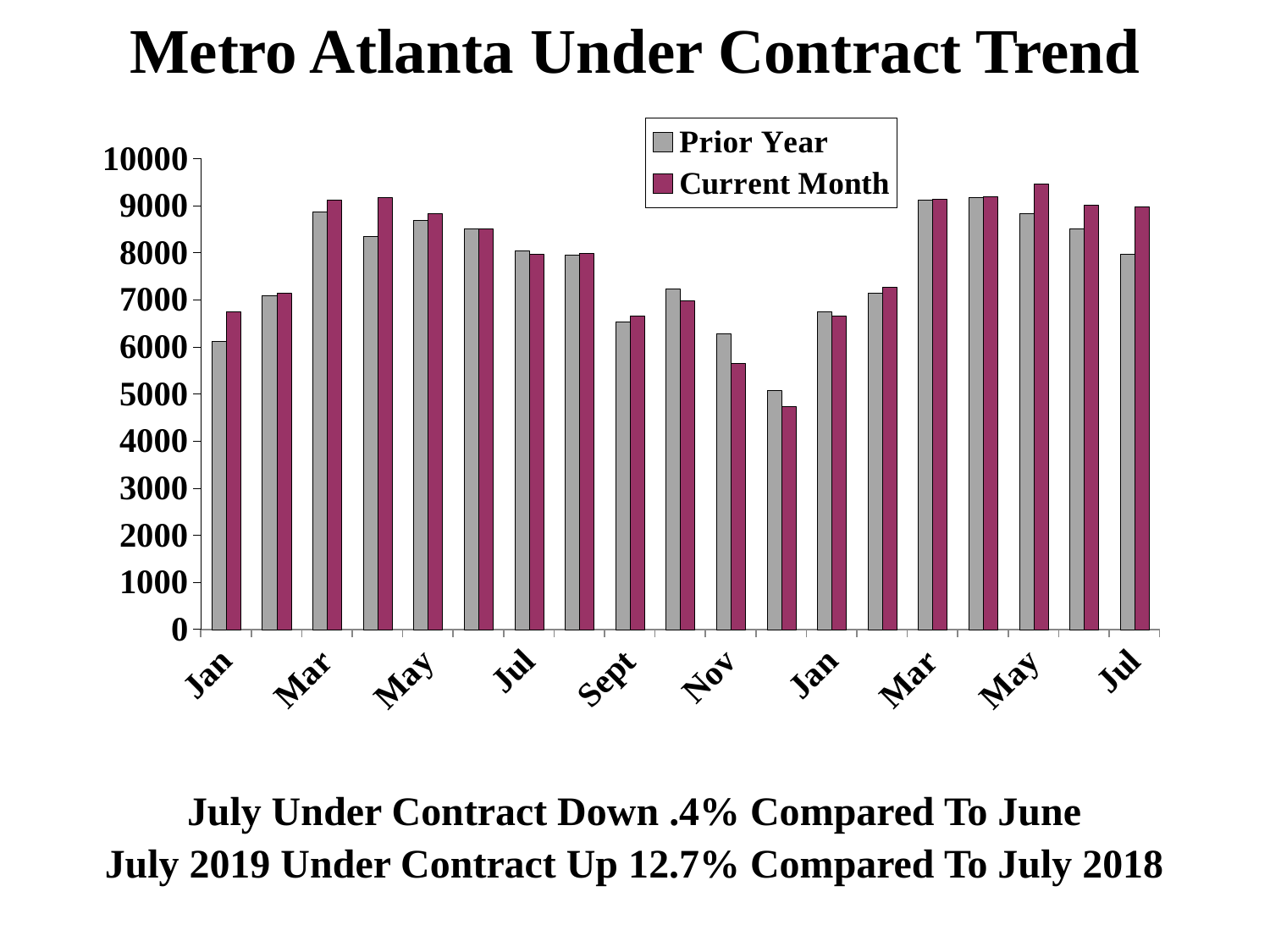
What is the title of the chart? Metro Atlanta Under Contract Trend Is the Prior Year value for the first Jan greater or less than 5000? greater For the first Nov, which is larger, the Prior Year value or the Current Month value? Prior Year How many series does the legend list? 2 Is the Current Month value for the first Sept greater or less than 7000? less Is the Prior Year value for the first May greater or less than 8000? greater What kind of chart is shown on the slide? bar chart Do the Current Month values rise or fall from the first Sept to the first Nov? fall Which series is shown in the darker (maroon) bars? Current Month For the second Jul, which is larger, the Prior Year value or the Current Month value? Current Month